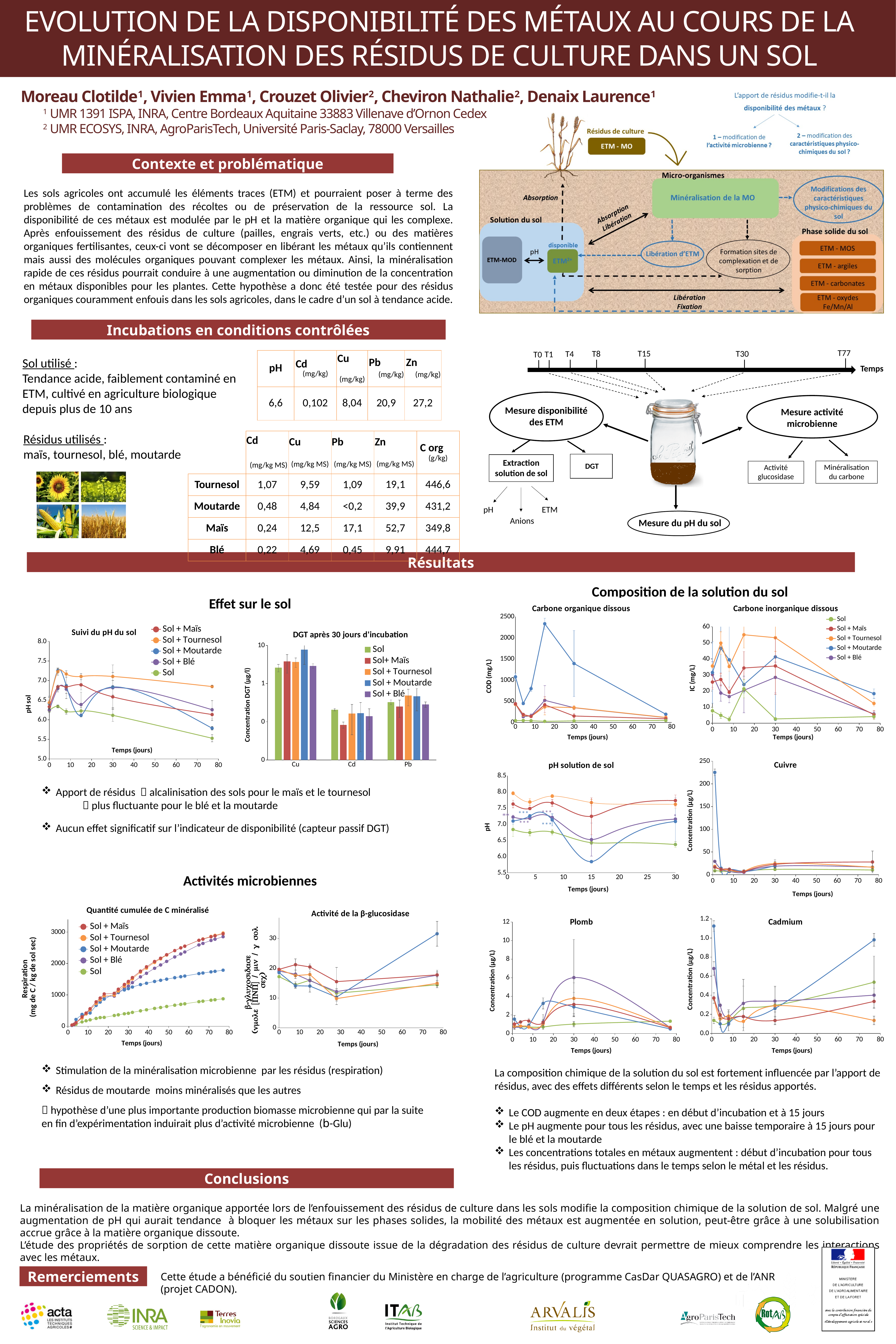
How many series does the legend of the "Suivi du pH du sol" chart list? 5 In the "Cuivre" chart, is the value for Sol + Moutarde at day 0 greater or less than 200? greater In the "Quantité cumulée de C minéralisé" chart, do the values rise or fall along the x axis? rise What is the y-axis label of the "Carbone organique dissous" chart? COD (mg/L) What kind of chart is "Quantité cumulée de C minéralisé"? line chart How many categories are shown on the x axis of the "DGT après 30 jours d'incubation" chart? 3 In the "Cadmium" chart, is the value for Sol + Moutarde at the last time point greater or less than 0.8? greater In the "Plomb" chart, is the peak value for Sol + Blé greater or less than 4? greater In the "Quantité cumulée de C minéralisé" chart, which series is lowest at the end of the incubation? Sol What kind of chart is "DGT après 30 jours d'incubation"? bar chart